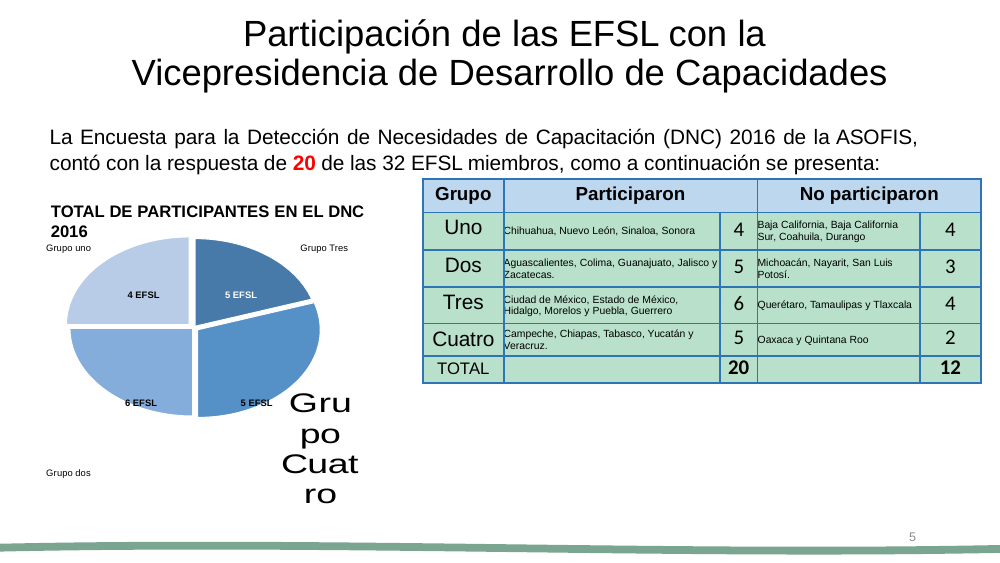
What is the value shown for Grupo Cuatro in the pie chart? 5 EFSL Which group has the smallest slice in the pie chart? Grupo uno What is the value shown for Grupo Tres in the pie chart? 5 EFSL What is the difference between the values for Grupo dos and Grupo uno in the pie chart? 2 EFSL Which is larger in the pie chart, Grupo dos or Grupo uno? Grupo dos What is the value shown for Grupo uno in the pie chart? 4 EFSL How many slices does the pie chart have? 4 What share of the pie chart does Grupo dos represent? 30% What is the value shown for Grupo dos in the pie chart? 6 EFSL What type of chart is shown on the slide? Pie chart What is the title of the pie chart? TOTAL DE PARTICIPANTES EN EL DNC 2016 Which group has the largest slice in the pie chart? Grupo dos